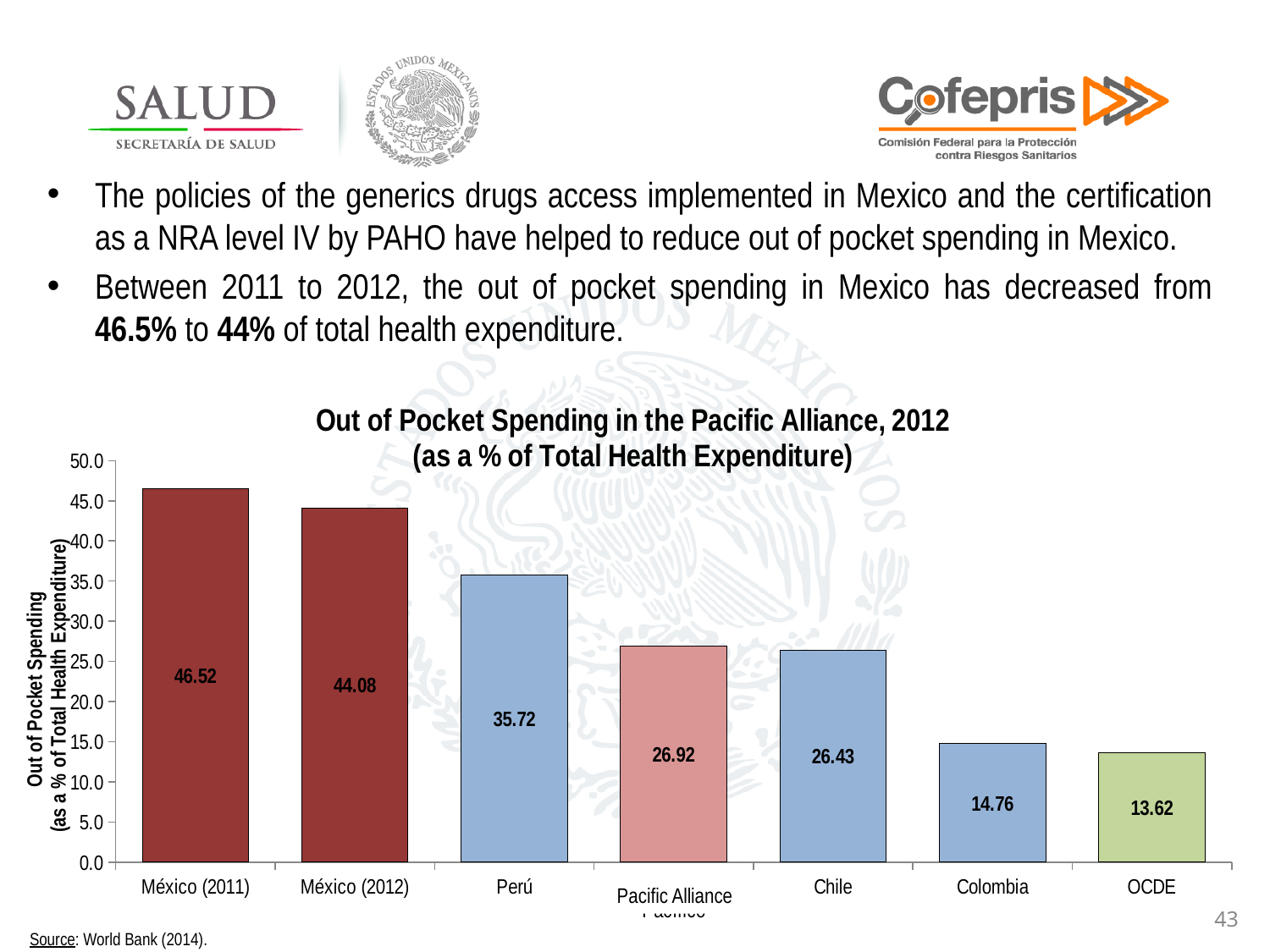
What is the value for Colombia in the chart? 14.76 Which category has the highest value in the chart? México (2011) What is the title of the chart? Out of Pocket Spending in the Pacific Alliance, 2012 (as a % of Total Health Expenditure) What is the difference between the values for Pacific Alliance and Chile? 0.49 What is the value for Perú in the chart? 35.72 How many categories are shown in the chart? 7 What is the value for OCDE in the chart? 13.62 Which category has the lowest value in the chart? OCDE What kind of chart is shown on the slide? bar chart What is the difference between the values for México (2011) and México (2012)? 2.44 Which is larger, the value for Perú or the value for Chile? Perú Is the value for Chile greater or less than 30.0? less